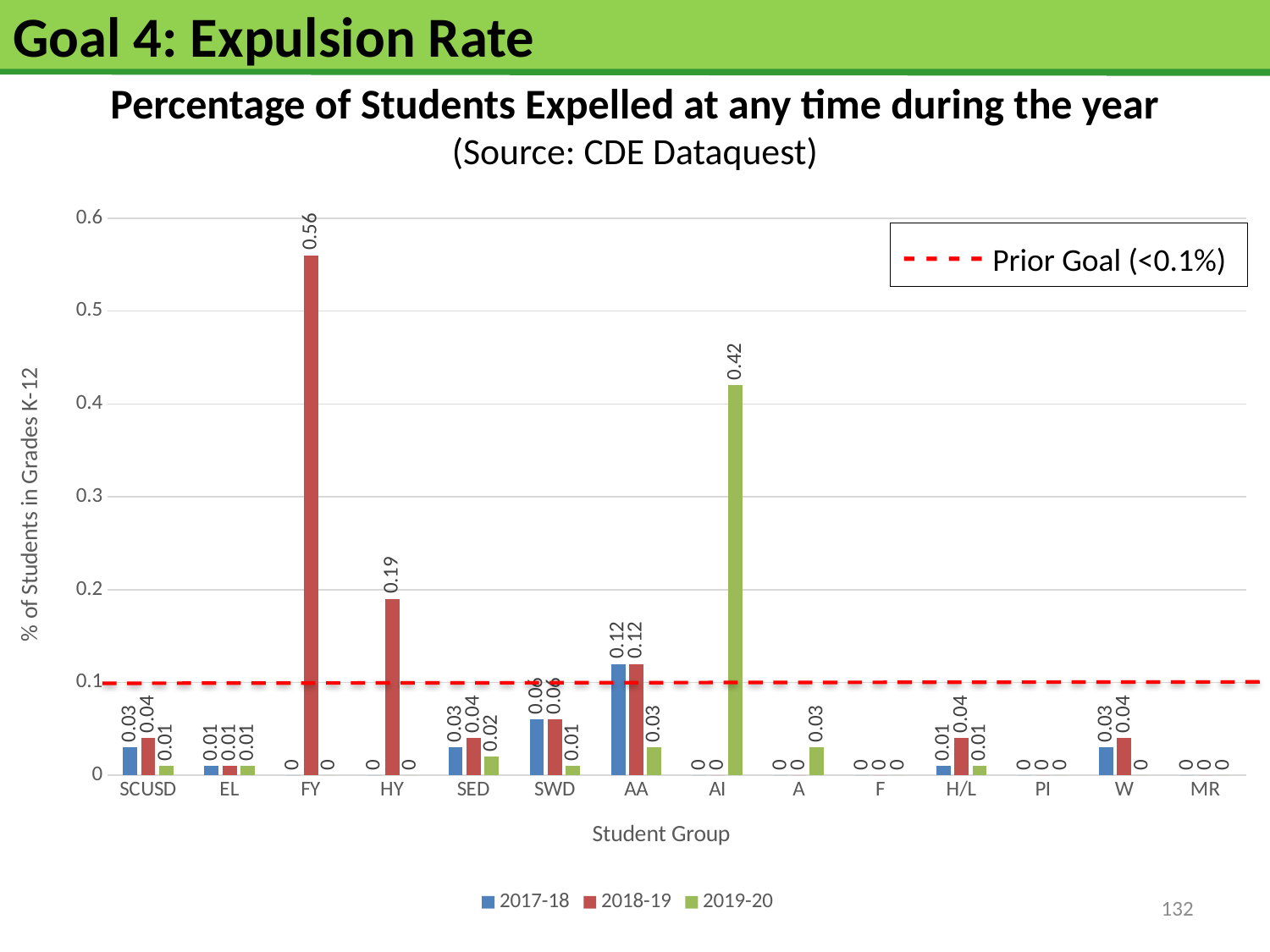
What is the value for AI in the 2019-20 series? 0.42 How many student groups are shown on the x axis? 14 What does the red dashed line on the chart represent? Prior Goal (<0.1%) What is the difference between the 2018-19 values for FY and HY? 0.37 What kind of chart is shown on the slide? Bar chart What is the value for HY in the 2018-19 series? 0.19 What is the value for FY in the 2018-19 series? 0.56 Which student group has the highest value in the 2019-20 series? AI Which is larger, the 2017-18 value for AA or the 2017-18 value for SCUSD? AA How many series does the legend list? 3 Which student group has the highest value in the 2018-19 series? FY What is the value for AA in the 2017-18 series? 0.12